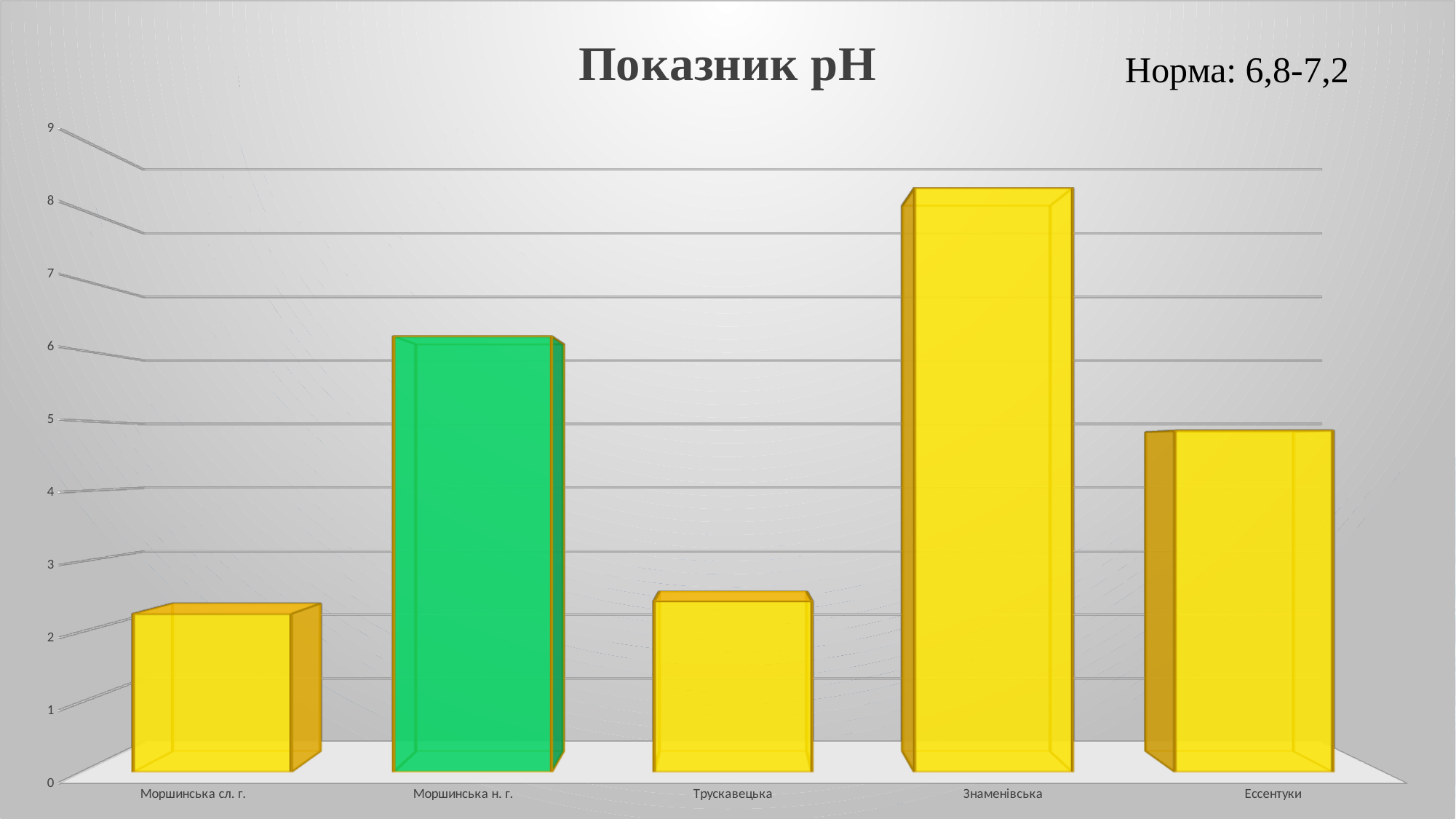
How many categories (water brands) are shown on the x axis? 5 What is the title of the chart? Показник pH Which is larger, the value for Ессентуки or the value for Трускавецька? Ессентуки Which category has the highest pH value? Знаменівська Is the value for Моршинська сл. г. greater or less than 3? less What kind of chart is shown on the slide? bar chart Is the value for Трускавецька greater or less than 3? less Is the value for Моршинська н. г. greater or less than 7? less Which category's bar is coloured green instead of yellow? Моршинська н. г. Which is larger, the value for Знаменівська or the value for Моршинська н. г.? Знаменівська